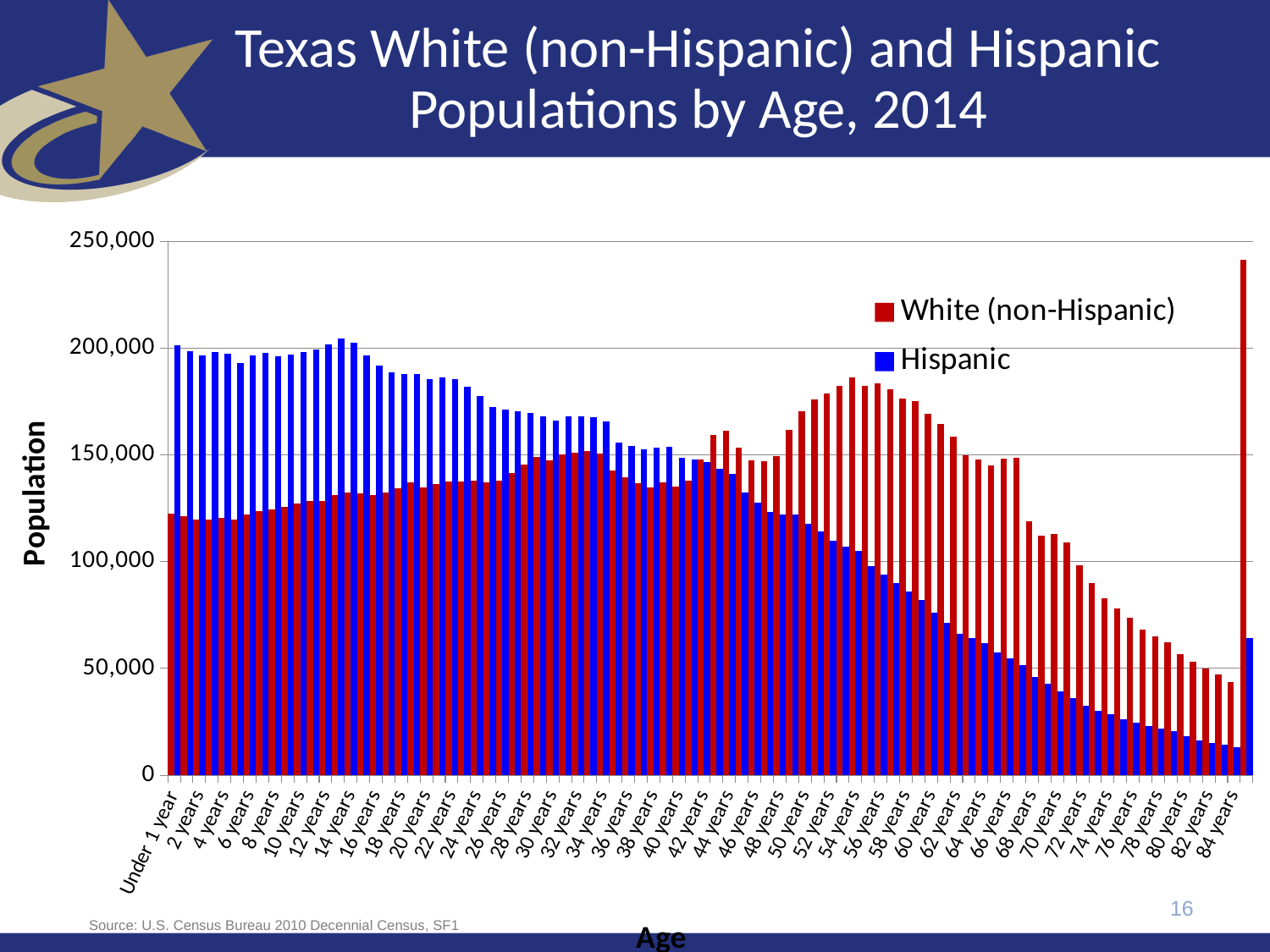
Is the White (non-Hispanic) value for 54 years greater or less than 150,000? greater Is the White (non-Hispanic) value for 2 years greater or less than 100,000? greater Is the Hispanic value for 14 years greater or less than 200,000? greater At 70 years, which series has the larger value, White (non-Hispanic) or Hispanic? White (non-Hispanic) Which colour represents the Hispanic series? Blue What kind of chart is shown on the slide? Bar chart How many series does the legend list? 2 Do the Hispanic values generally rise or fall from 14 years to 84 years? Fall What is the title of the chart? Texas White (non-Hispanic) and Hispanic Populations by Age, 2014 At 2 years, which series has the larger value, White (non-Hispanic) or Hispanic? Hispanic